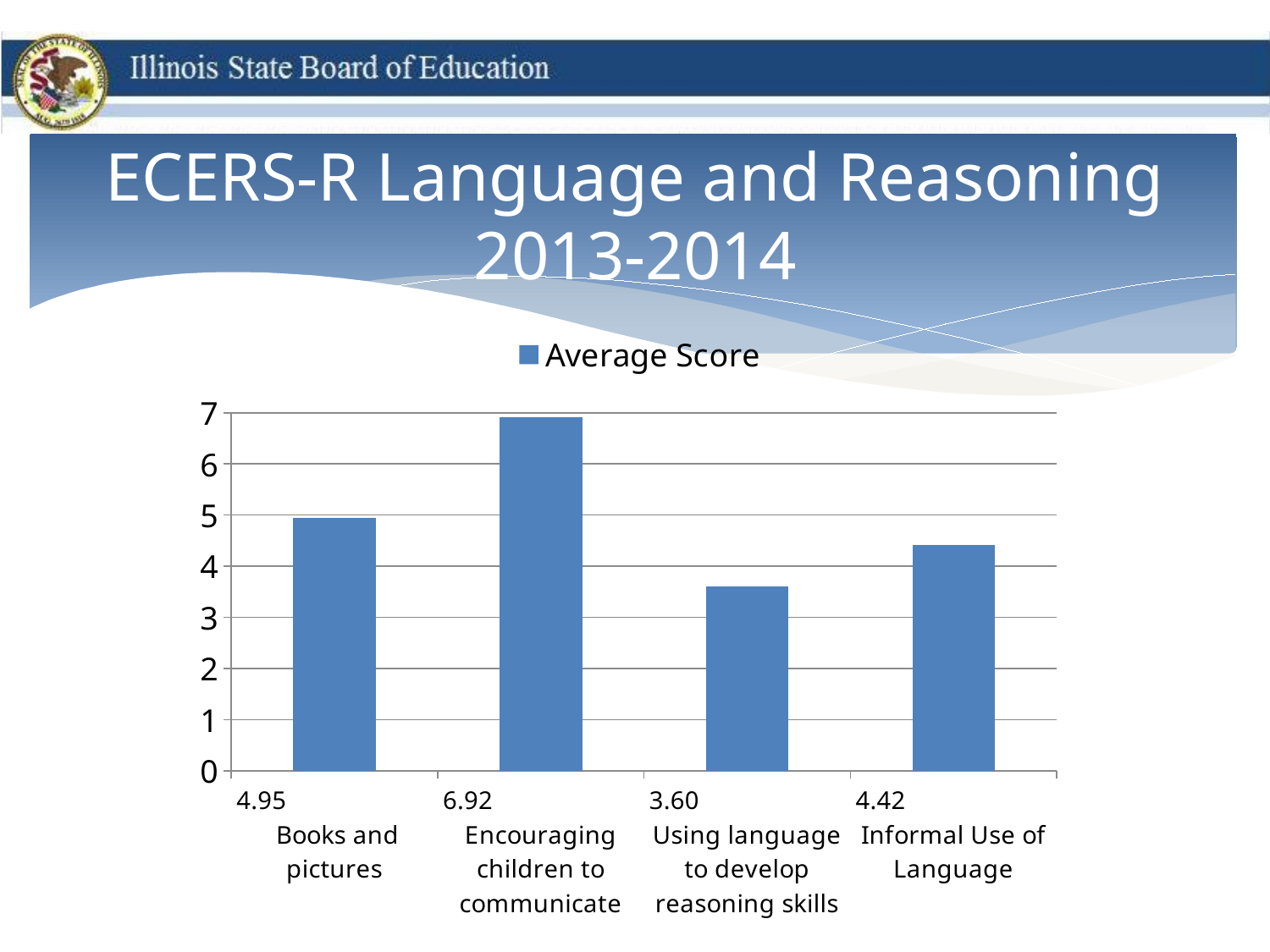
What is the difference between the average scores for Encouraging children to communicate and Using language to develop reasoning skills? 3.32 What series does the legend list? Average Score How many categories are shown in the chart? 4 What is the average score for Books and pictures? 4.95 What is the average score for Using language to develop reasoning skills? 3.60 Which has a higher average score, Books and pictures or Informal Use of Language? Books and pictures What kind of chart is shown on the slide? Bar chart What is the average score for Informal Use of Language? 4.42 Which category has the lowest average score? Using language to develop reasoning skills What is the average score for Encouraging children to communicate? 6.92 Which category has the highest average score? Encouraging children to communicate What is the difference between the average scores for Books and pictures and Informal Use of Language? 0.53